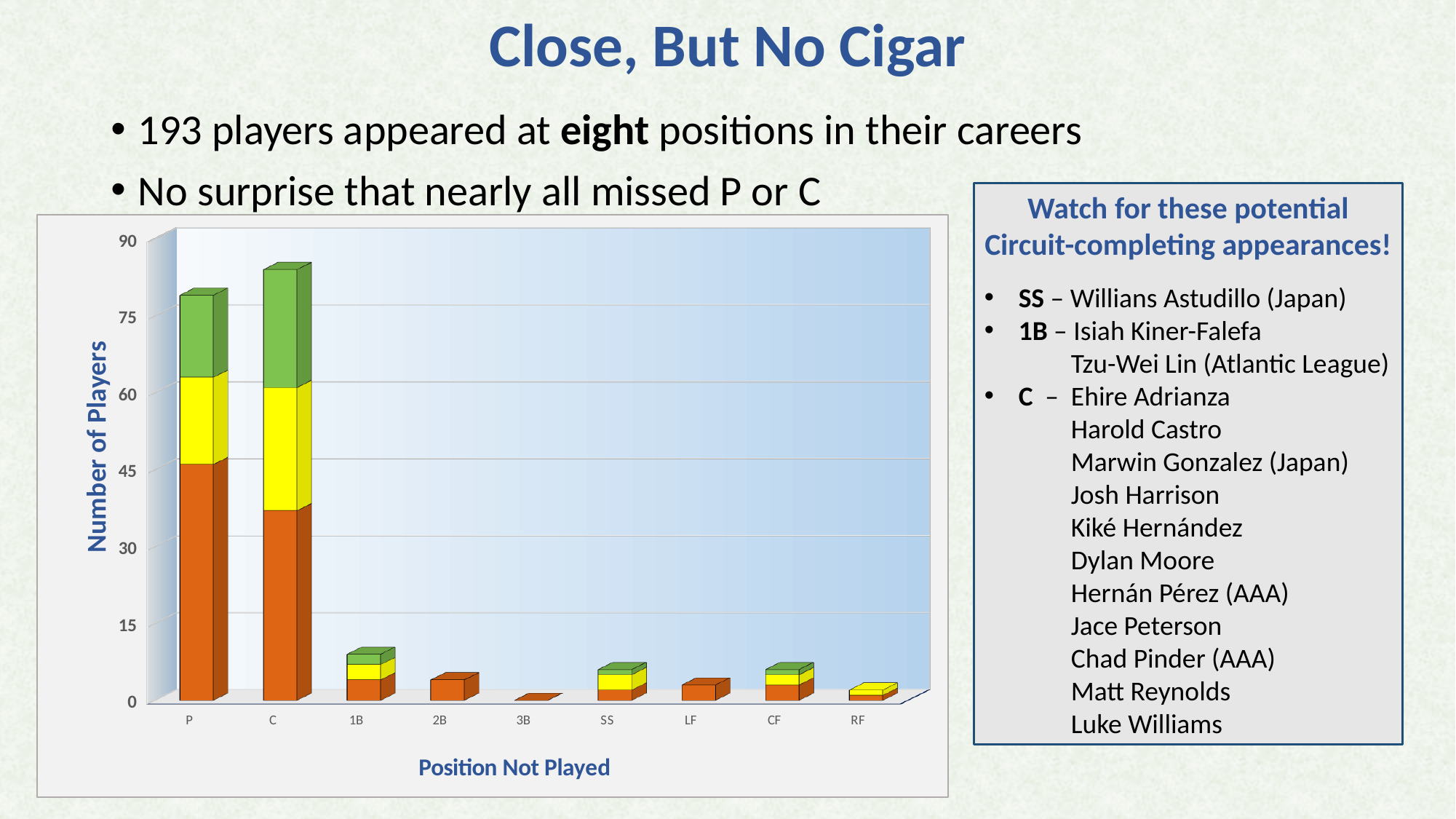
Which bar is taller, 2B or 3B? 2B What kind of chart is shown on the slide? Stacked bar chart What is the title of the horizontal axis of the chart? Position Not Played Which position has the shortest bar in the chart? 3B Is the total value for SS greater or less than 15? less Is the total value for 1B greater or less than 15? less Which position has the tallest bar in the chart? C Is the total value for C greater or less than 75? greater How many positions are shown along the x axis of the chart? 9 What is the title of the vertical axis of the chart? Number of Players Which bar is taller, P or 1B? P